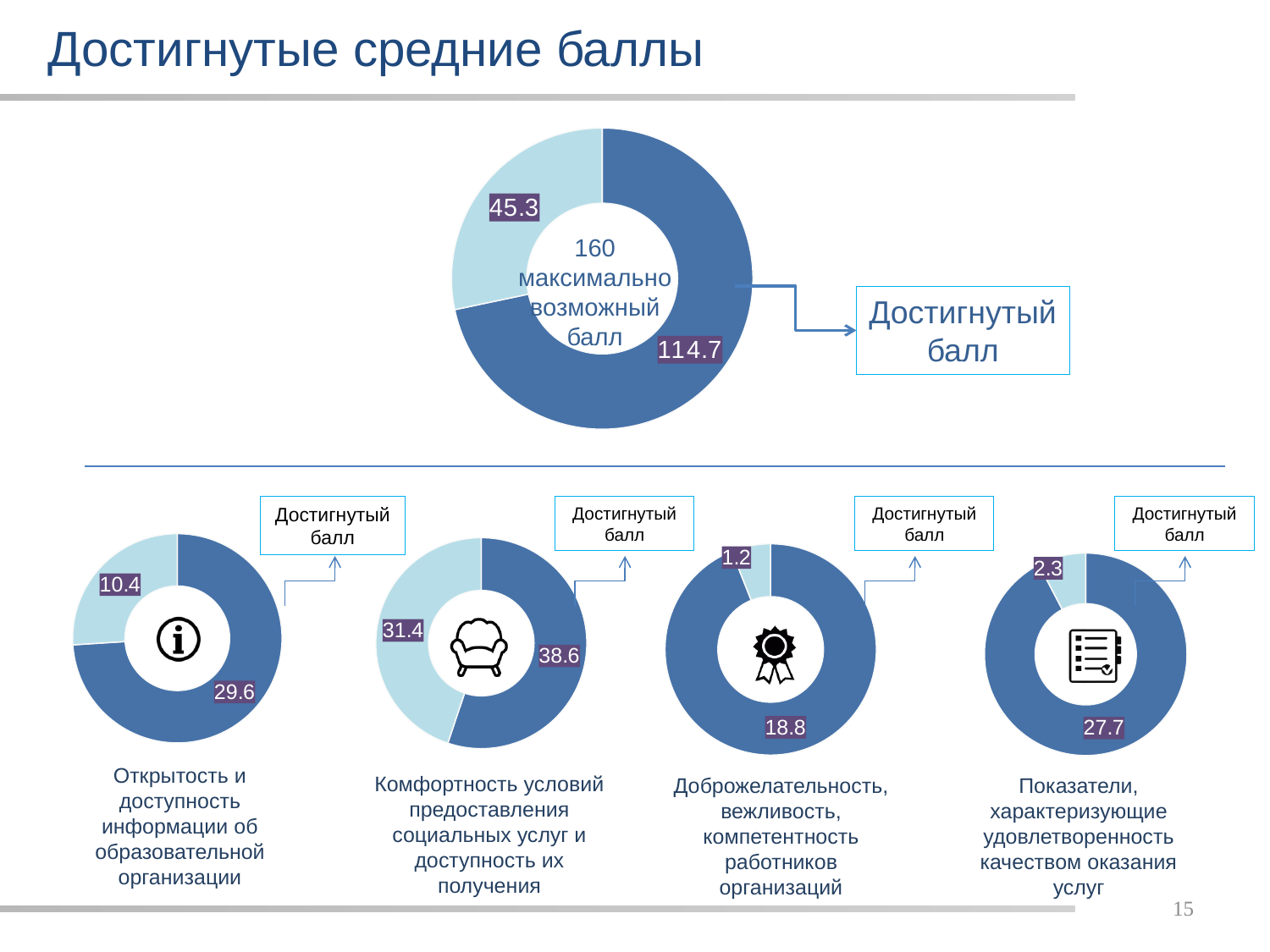
On the large donut chart at the top of the slide, what value is shown on the light blue segment? 45.3 What maximum possible score is stated in the centre of the large donut chart at the top of the slide? 160 On the large donut chart at the top of the slide, what is the achieved score (Достигнутый балл) shown on the dark blue segment? 114.7 On the bottom-right donut chart (Показатели, характеризующие удовлетворенность качеством оказания услуг), what value is shown on the light blue segment? 2.3 Among the four small donut charts at the bottom of the slide, which one has the highest achieved score on its dark blue segment? Комфортность условий предоставления социальных услуг и доступность их получения (38.6) On the large donut chart at the top of the slide, what is the difference between the two segment values, 114.7 and 45.3? 69.4 On the third donut chart from the left at the bottom (Доброжелательность, вежливость, компетентность работников организаций), what is the achieved score shown on the dark blue segment? 18.8 What type of chart is used for the large chart at the top of the slide? Donut chart On the third donut chart from the left at the bottom, what is the total of the two segment values, 18.8 and 1.2? 20.0 On the second donut chart from the left at the bottom (Комфортность условий предоставления социальных услуг), what value is shown on the light blue segment? 31.4 On the bottom-left donut chart (Открытость и доступность информации об образовательной организации), what is the achieved score shown on the dark blue segment? 29.6 How many donut charts are shown on the slide in total? 5